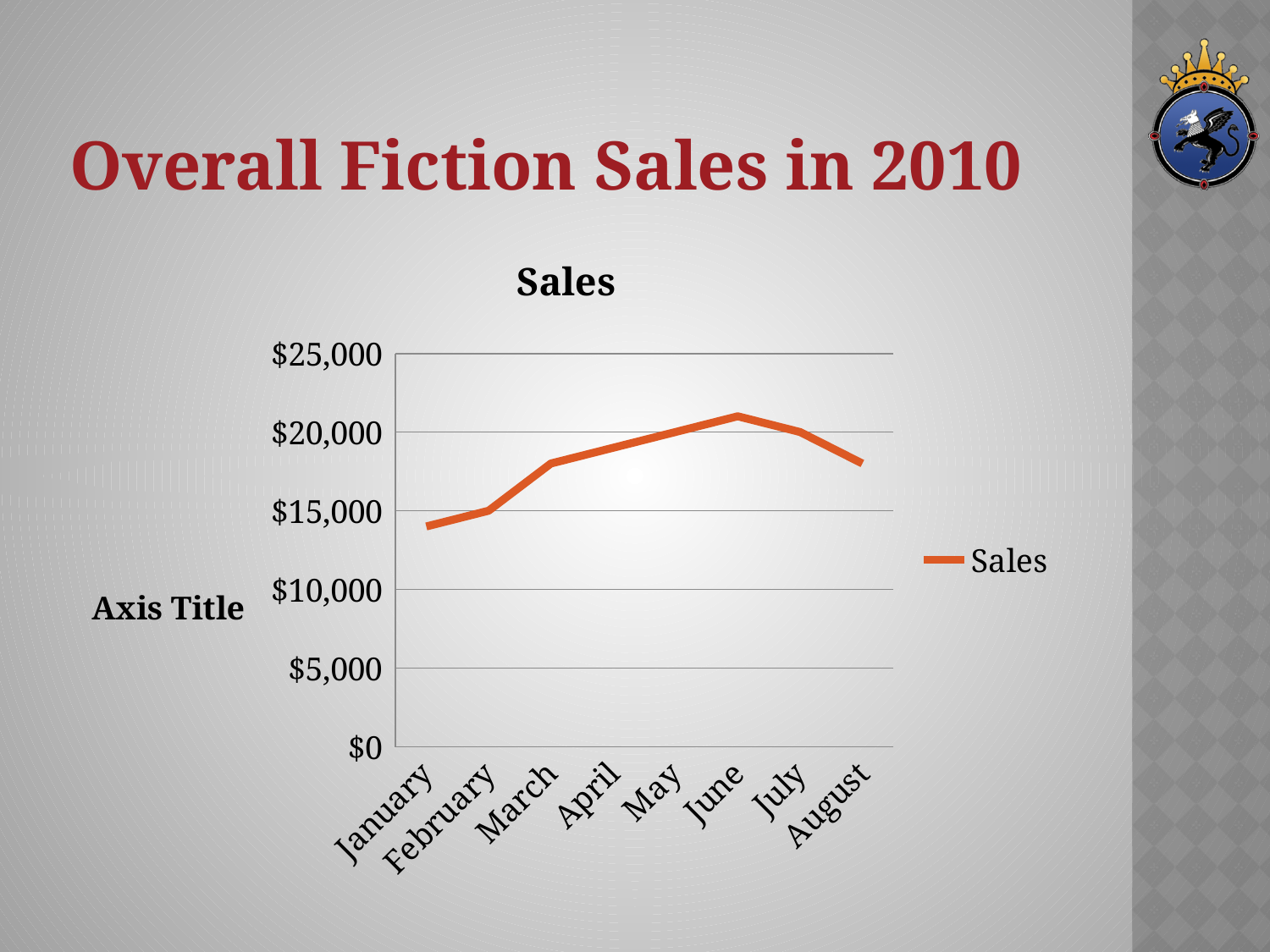
How do sales change from January to June? they rise Is the sales value for August greater or less than $20,000? less Is the sales value for March greater or less than $15,000? greater How many series does the legend list? 1 Which month has the lowest sales value? January Which has the larger sales value, March or January? March Is the sales value for January greater or less than $15,000? less How many months are plotted on the x axis? 8 What kind of chart is shown on the slide? line chart Which has the larger sales value, June or August? June Which month has the highest sales value? June